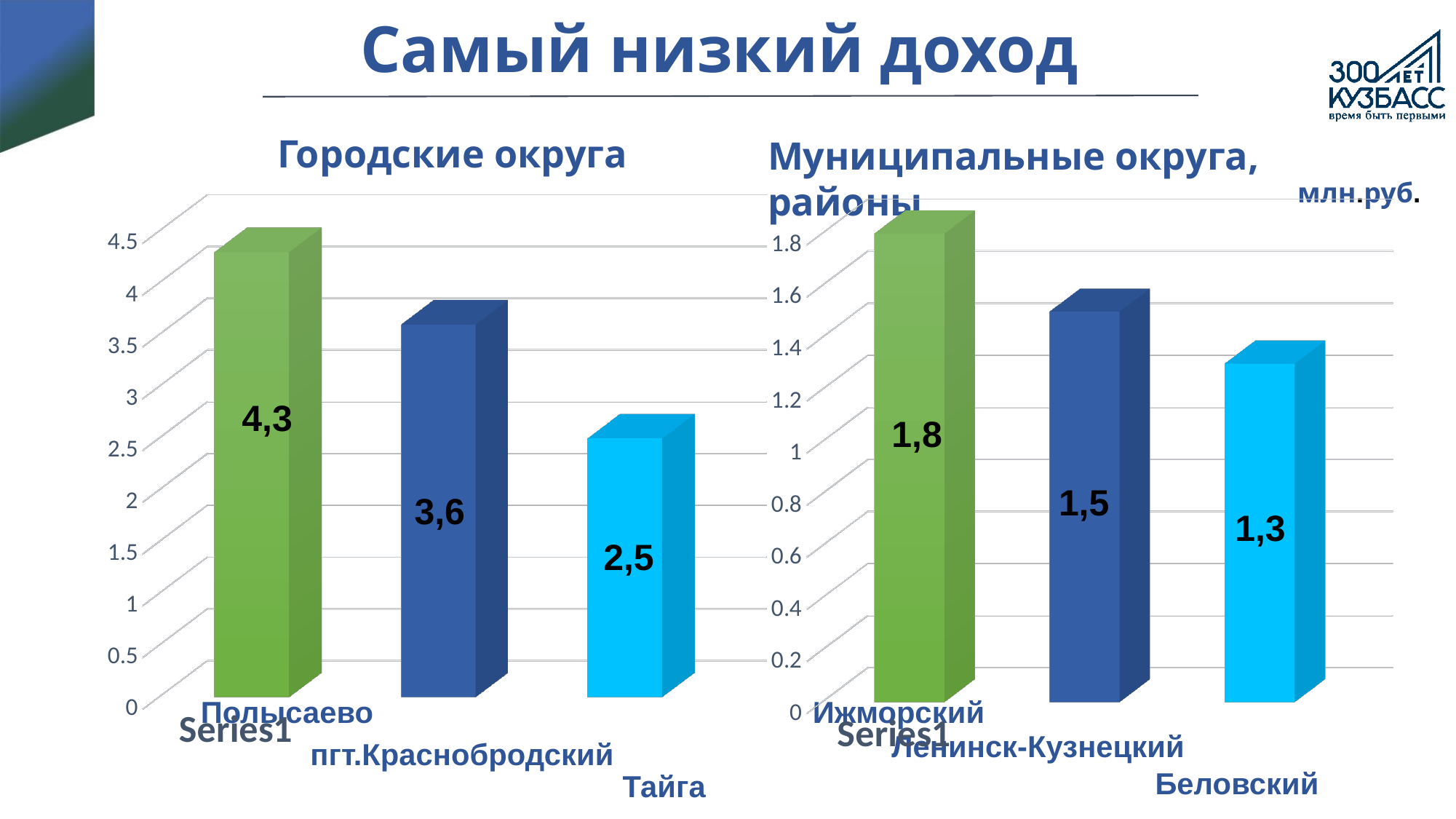
In the 'Муниципальные округа, районы' chart, do the values rise or fall from left to right? Fall In the 'Муниципальные округа, районы' chart, what is the value for Беловский? 1,3 In the 'Городские округа' chart, what is the value for Полысаево? 4,3 In the 'Городские округа' chart, what is the difference between the values for Полысаево and Тайга? 1,8 In the 'Муниципальные округа, районы' chart, which category has the lowest value? Беловский In the 'Муниципальные округа, районы' chart, what is the value for Ленинск-Кузнецкий? 1,5 In the 'Муниципальные округа, районы' chart, what is the difference between the values for Ижморский and Беловский? 0,5 How many categories are shown in the 'Муниципальные округа, районы' chart? 3 In the 'Городские округа' chart, what is the value for Тайга? 2,5 What kind of chart is the 'Городские округа' chart? Bar chart In the 'Городские округа' chart, which category has the highest value? Полысаево In the 'Городские округа' chart, which is larger: the value for пгт.Краснобродский or the value for Тайга? пгт.Краснобродский